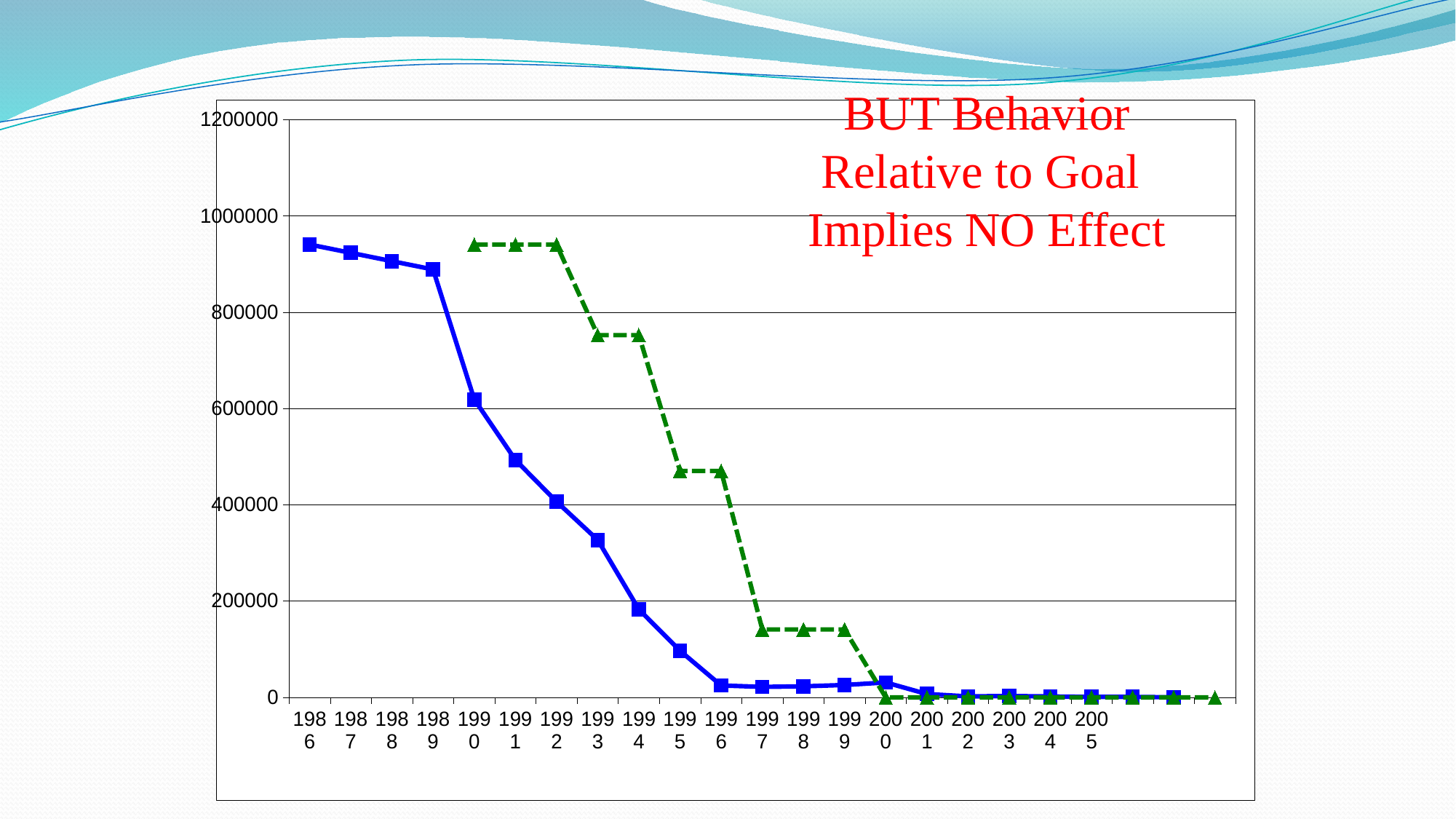
What is the highest value shown on the y axis? 1200000 Is the value of the blue solid line in 1993 greater or less than 400000? less Is the value of the green dashed line in 1996 greater or less than 600000? less Is the value of the green dashed line in 1997 greater or less than 200000? less How many data series are plotted on the chart? 2 What is the first year labelled on the x axis? 1986 What kind of chart is shown on the slide? line chart Does the blue solid line generally rise or fall from 1986 to 2005? fall In 1992, which line has the larger value, the blue solid line or the green dashed line? green dashed line